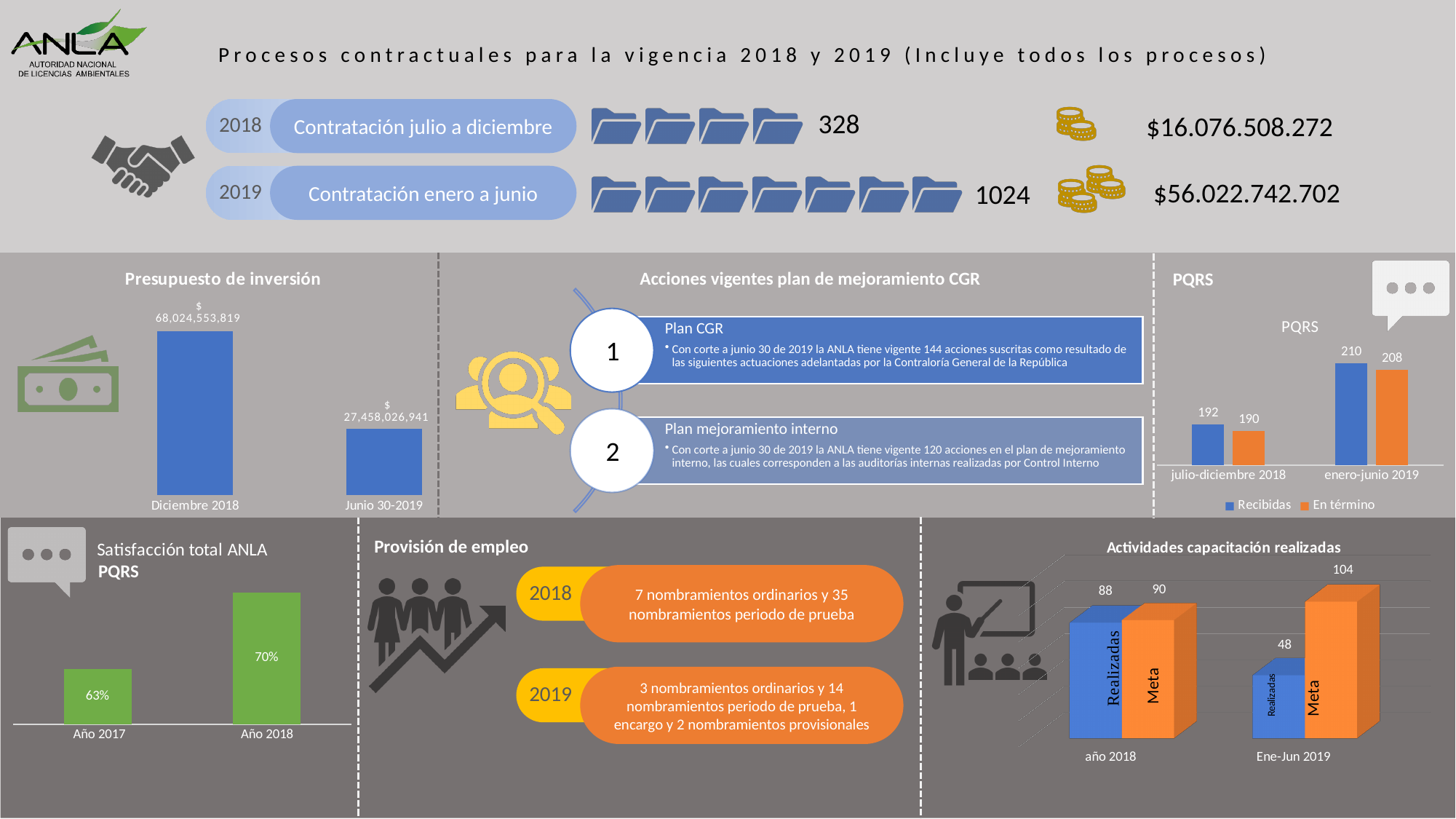
How many series does the legend of the 'PQRS' chart list? 2 In the 'Presupuesto de inversión' chart, what is the value for Diciembre 2018? $ 68,024,553,819 In the 'Actividades capacitación realizadas' chart, what is the Meta value for Ene-Jun 2019? 104 What kind of chart is the 'Actividades capacitación realizadas' chart? bar chart In the 'PQRS' chart, what is the value of Recibidas for enero-junio 2019? 210 In the 'Actividades capacitación realizadas' chart, what is the difference between Meta and Realizadas for año 2018? 2 In the 'Satisfacción total ANLA PQRS' chart, do the values rise or fall from Año 2017 to Año 2018? rise In the 'Presupuesto de inversión' chart, what is the value for Junio 30-2019? $ 27,458,026,941 In the 'Presupuesto de inversión' chart, which category has the higher value? Diciembre 2018 In the 'Satisfacción total ANLA PQRS' chart, what is the value for Año 2018? 70% In the 'PQRS' chart, what is the difference between Recibidas and En término for julio-diciembre 2018? 2 In the 'PQRS' chart, what is the value of En término for julio-diciembre 2018? 190